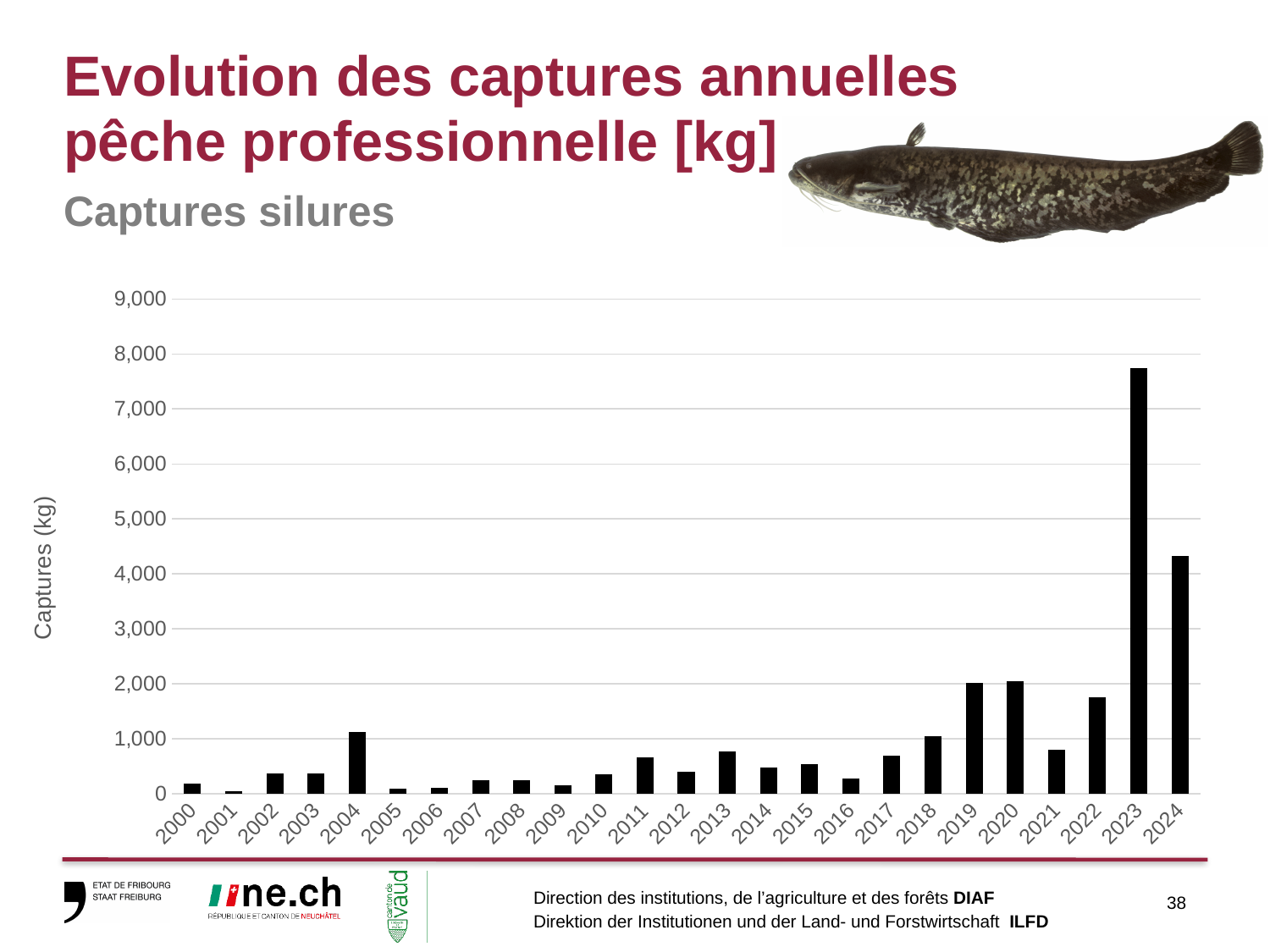
Which year has the larger catch, 2019 or 2021? 2019 Is the value for 2004 greater or less than 1,000? greater Which year has the lowest catch of silures? 2001 How many years are plotted on the x axis of the chart? 25 Which year has the larger catch, 2023 or 2024? 2023 What kind of chart is shown on the slide? bar chart What is the subtitle of the chart shown on the slide? Captures silures Is the value for 2023 greater or less than 7,000? greater Which year has the highest catch of silures? 2023 Is the value for 2024 greater or less than 4,000? greater What is the label of the y axis? Captures (kg)